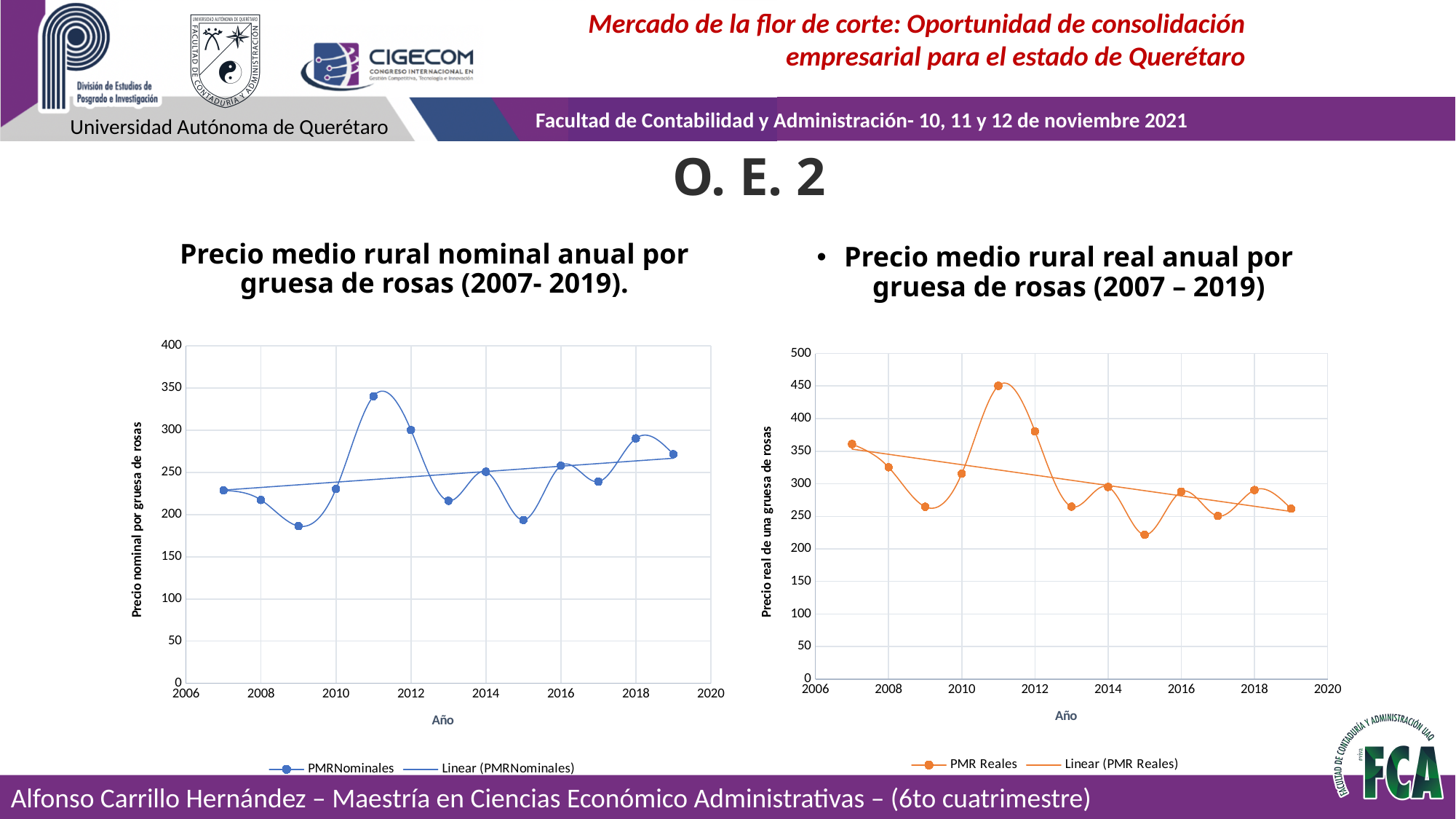
In the left chart (Precio medio rural nominal anual por gruesa de rosas), does the linear trend line rise or fall from 2007 to 2019? rise In the right chart (Precio medio rural real anual por gruesa de rosas), which year has the lowest real price? 2015 In the left chart (Precio medio rural nominal anual por gruesa de rosas), which year has the lowest nominal price? 2009 In the left chart (Precio medio rural nominal anual por gruesa de rosas), which is larger, the value for 2018 or the value for 2017? 2018 What type of chart is the right chart (Precio medio rural real anual por gruesa de rosas)? line chart In the left chart (Precio medio rural nominal anual por gruesa de rosas), how many data points are plotted? 13 In the right chart (Precio medio rural real anual por gruesa de rosas), which year has the highest real price? 2011 In the right chart (Precio medio rural real anual por gruesa de rosas), does the linear trend line rise or fall from 2007 to 2019? fall In the left chart (Precio medio rural nominal anual por gruesa de rosas), is the value for 2011 greater or less than 300? greater In the left chart (Precio medio rural nominal anual por gruesa de rosas), is the value for 2009 greater or less than 200? less In the right chart (Precio medio rural real anual por gruesa de rosas), is the value for 2011 greater or less than 400? greater In the left chart (Precio medio rural nominal anual por gruesa de rosas), which year has the highest nominal price? 2011